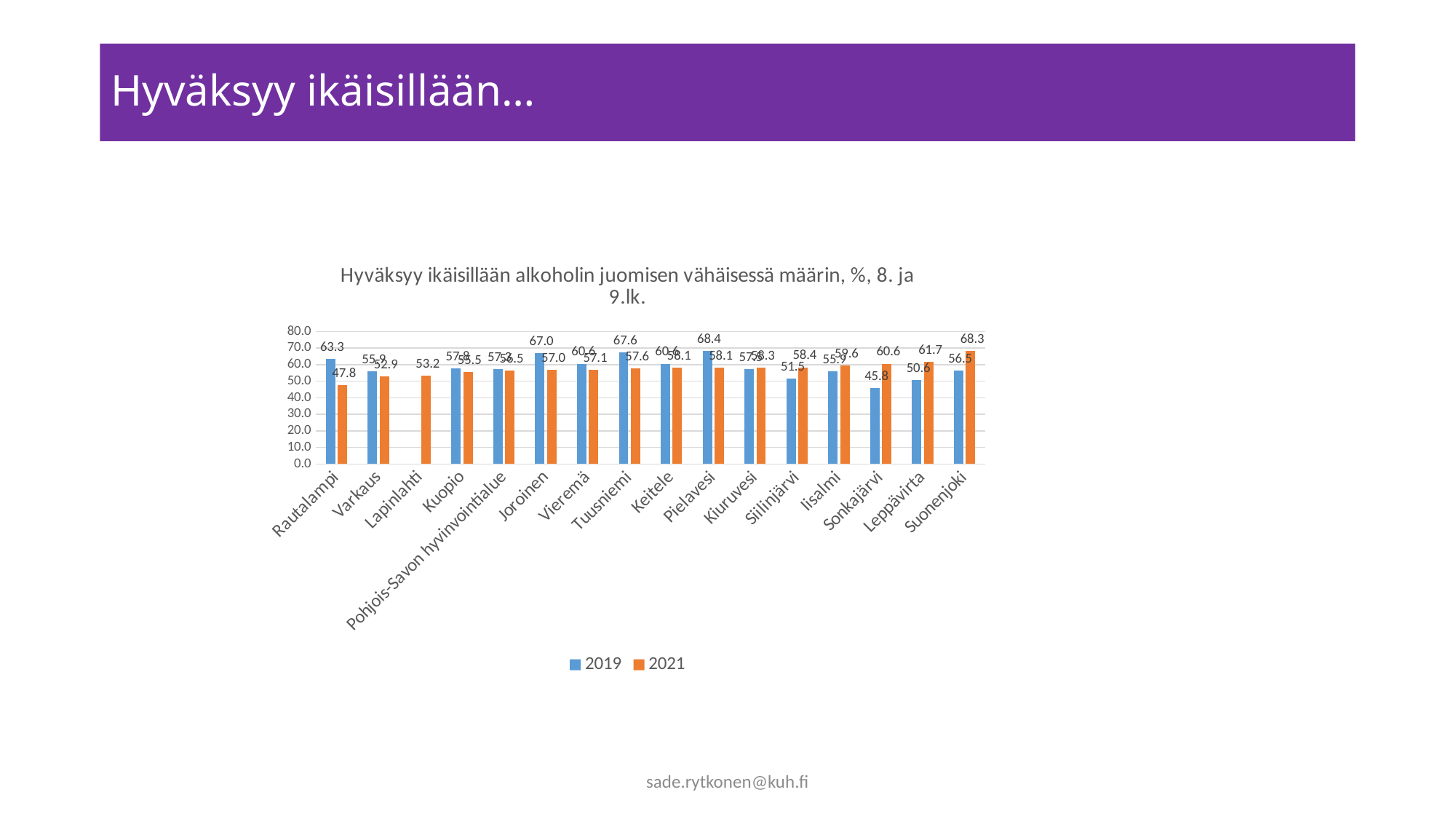
Which category has the highest 2019 value? Pielavesi What is the 2021 value for Lapinlahti? 53.2 How many series does the legend list? 2 Is the 2019 value for Joroinen greater or less than 60.0? greater What is the difference between the 2019 and 2021 values for Rautalampi? 15.5 Do the 2021 values generally rise or fall from left to right along the x axis? rise Which is larger for Suonenjoki, the 2019 value or the 2021 value? 2021 How many categories are shown on the x axis? 16 Which category has the lowest 2019 value? Sonkajärvi What is the 2021 value for Sonkajärvi? 60.6 What is the 2019 value for Rautalampi? 63.3 Which category has the highest 2021 value? Suonenjoki